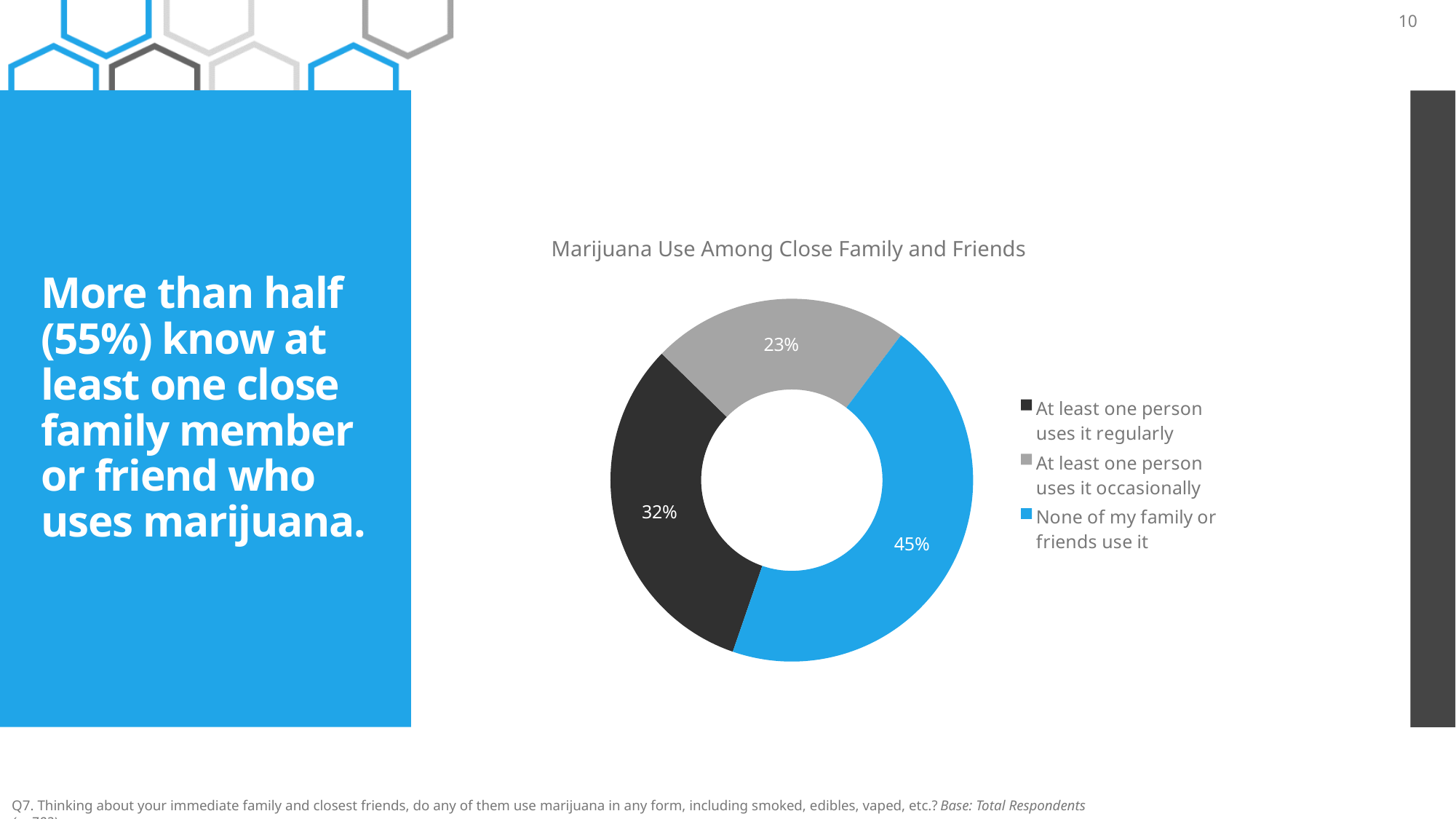
What is the combined share of respondents who know at least one person who uses it regularly or occasionally? 55% Which category has the smallest share of the chart? At least one person uses it occasionally What is the difference in percentage points between 'None of my family or friends use it' and 'At least one person uses it regularly'? 13 What kind of chart is shown on the slide? Doughnut chart How many categories are shown in the chart? 3 Which category has the largest share of the chart? None of my family or friends use it Which colour represents 'None of my family or friends use it' in the chart? Blue What is the title of the chart? Marijuana Use Among Close Family and Friends What percentage of respondents said at least one person uses it occasionally? 23% What percentage of respondents said at least one person uses it regularly? 32% Which is larger: the share for 'At least one person uses it regularly' or 'At least one person uses it occasionally'? At least one person uses it regularly What percentage of respondents said none of their family or friends use marijuana? 45%